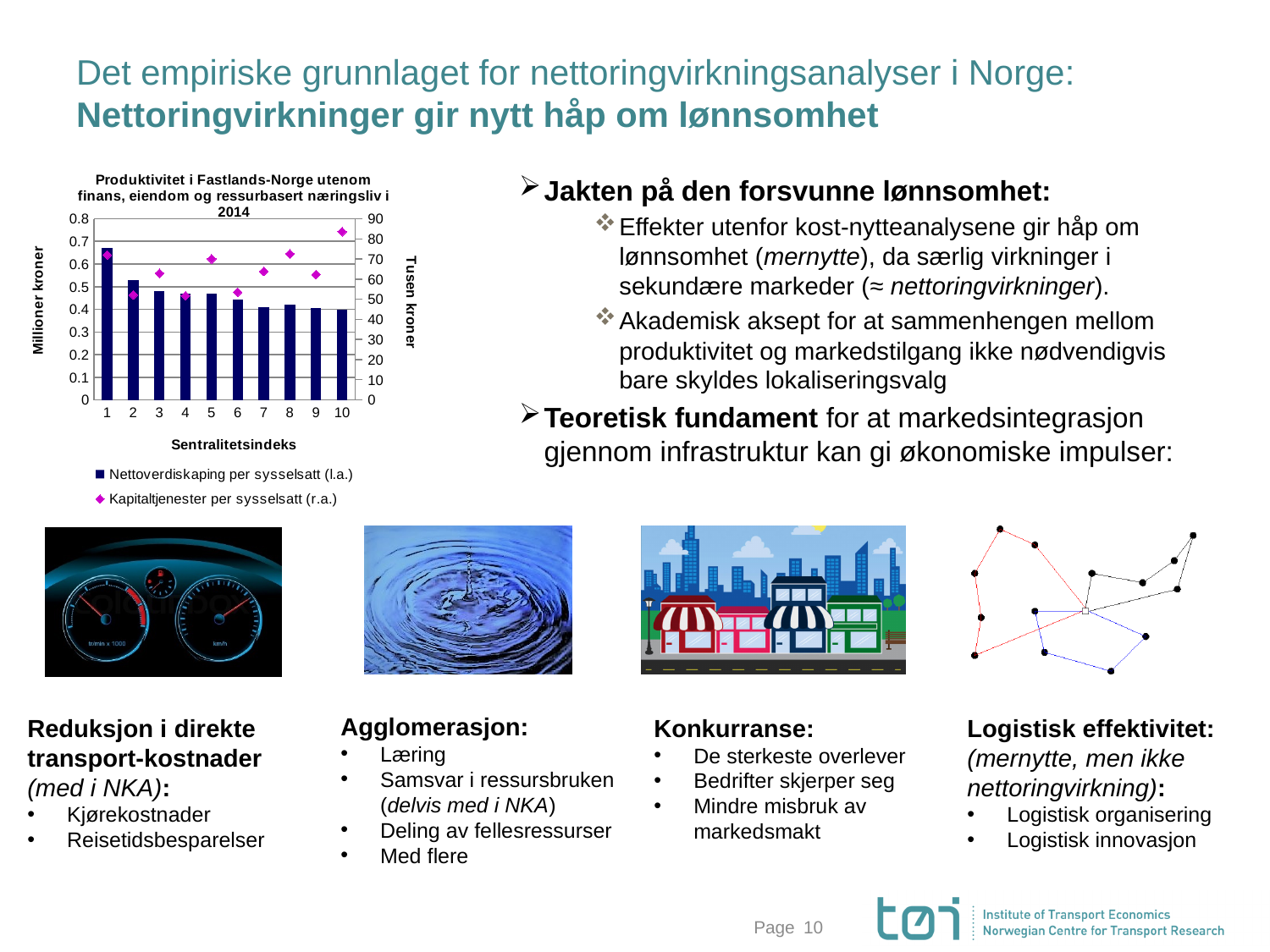
Is the Kapitaltjenester per sysselsatt value for Sentralitetsindeks 10 greater or less than 80? greater Do the Nettoverdiskaping per sysselsatt bars generally rise or fall as Sentralitetsindeks increases from 1 to 10? fall Which Sentralitetsindeks category has the highest value for Kapitaltjenester per sysselsatt? 10 Which Sentralitetsindeks category has the highest bar for Nettoverdiskaping per sysselsatt? 1 Is the Nettoverdiskaping per sysselsatt bar for Sentralitetsindeks 10 greater or less than 0.5? less How many series does the chart's legend list? 2 Which has the larger Nettoverdiskaping per sysselsatt bar, Sentralitetsindeks 1 or Sentralitetsindeks 2? 1 What kind of chart is used to show Nettoverdiskaping per sysselsatt on the slide? bar chart Is the Nettoverdiskaping per sysselsatt bar for Sentralitetsindeks 1 greater or less than 0.6? greater What is the title of the chart's left vertical axis? Millioner kroner How many categories (Sentralitetsindeks values) are shown on the x axis of the chart? 10